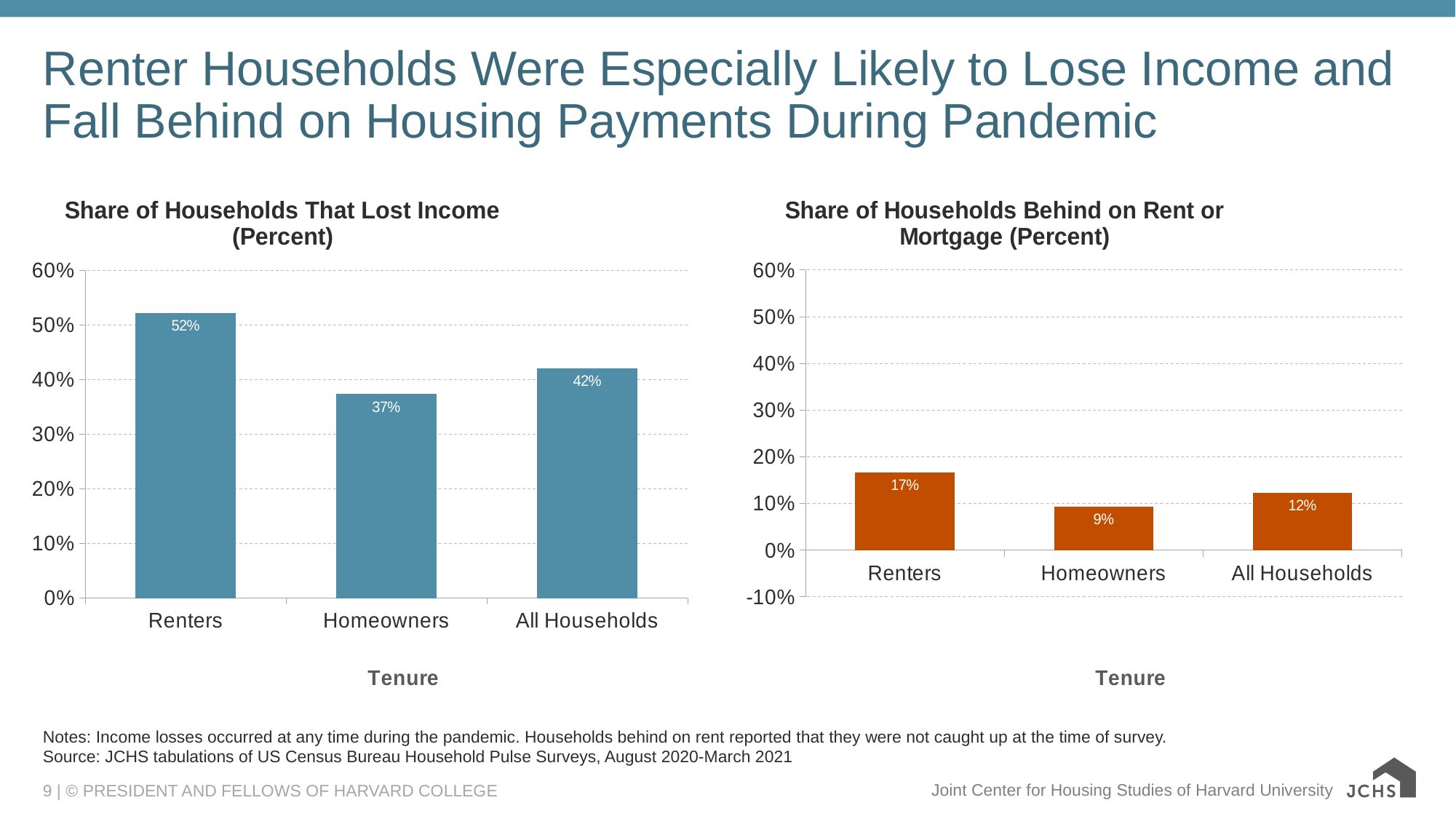
In the 'Share of Households That Lost Income (Percent)' chart, which category has the highest value? Renters In the 'Share of Households Behind on Rent or Mortgage (Percent)' chart, is the value for Renters greater or less than 20%? less How many categories are shown in the 'Share of Households That Lost Income (Percent)' chart? 3 In the 'Share of Households Behind on Rent or Mortgage (Percent)' chart, what is the value for All Households? 12% In the 'Share of Households That Lost Income (Percent)' chart, what is the value for Renters? 52% In the 'Share of Households That Lost Income (Percent)' chart, what is the value for Homeowners? 37% What kind of chart is the 'Share of Households Behind on Rent or Mortgage (Percent)' chart? Bar chart In the 'Share of Households Behind on Rent or Mortgage (Percent)' chart, what is the value for Homeowners? 9% In the 'Share of Households Behind on Rent or Mortgage (Percent)' chart, what is the difference between the values for Renters and All Households? 5% In the 'Share of Households Behind on Rent or Mortgage (Percent)' chart, which category has the lowest value? Homeowners In the 'Share of Households That Lost Income (Percent)' chart, what is the difference between the values for Renters and Homeowners? 15% In the 'Share of Households That Lost Income (Percent)' chart, which is larger: the value for Homeowners or the value for All Households? All Households